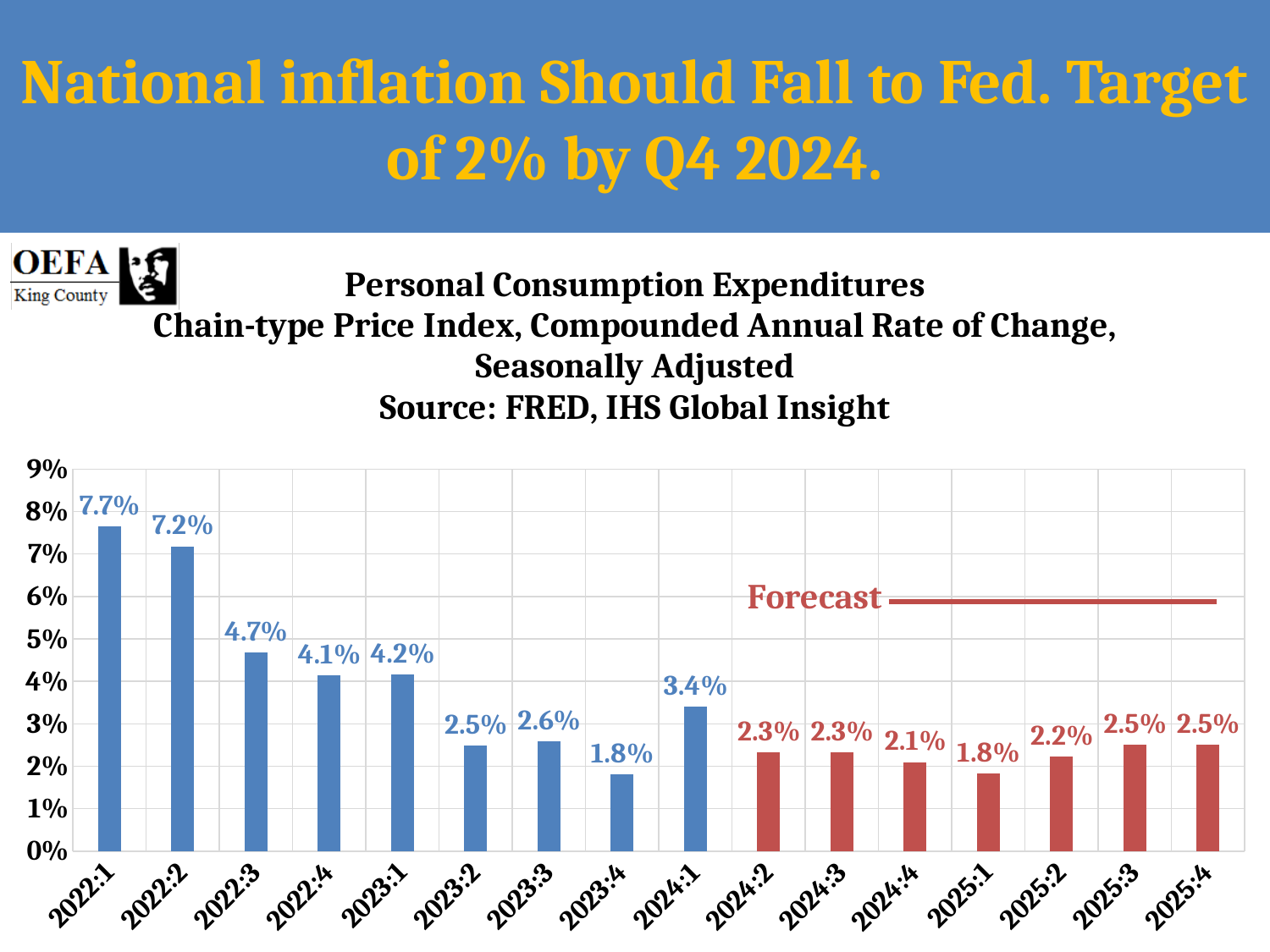
What is the value for 2022:1? 7.7% How many quarters are shown on the x axis? 16 Which quarter has the highest value? 2022:1 What is the value for 2024:1? 3.4% What kind of chart is this? bar chart What is the forecast value for 2025:1? 1.8% What is the difference between the values for 2024:1 and 2024:2? 1.1% What is the difference between the values for 2022:1 and 2022:2? 0.5% What label is shown next to the red line above the red bars? Forecast Which is larger, the value for 2022:3 or the value for 2023:1? 2022:3 Is the value for 2023:4 greater or less than 2%? less Do the values generally rise or fall from 2022:1 to 2023:4? fall